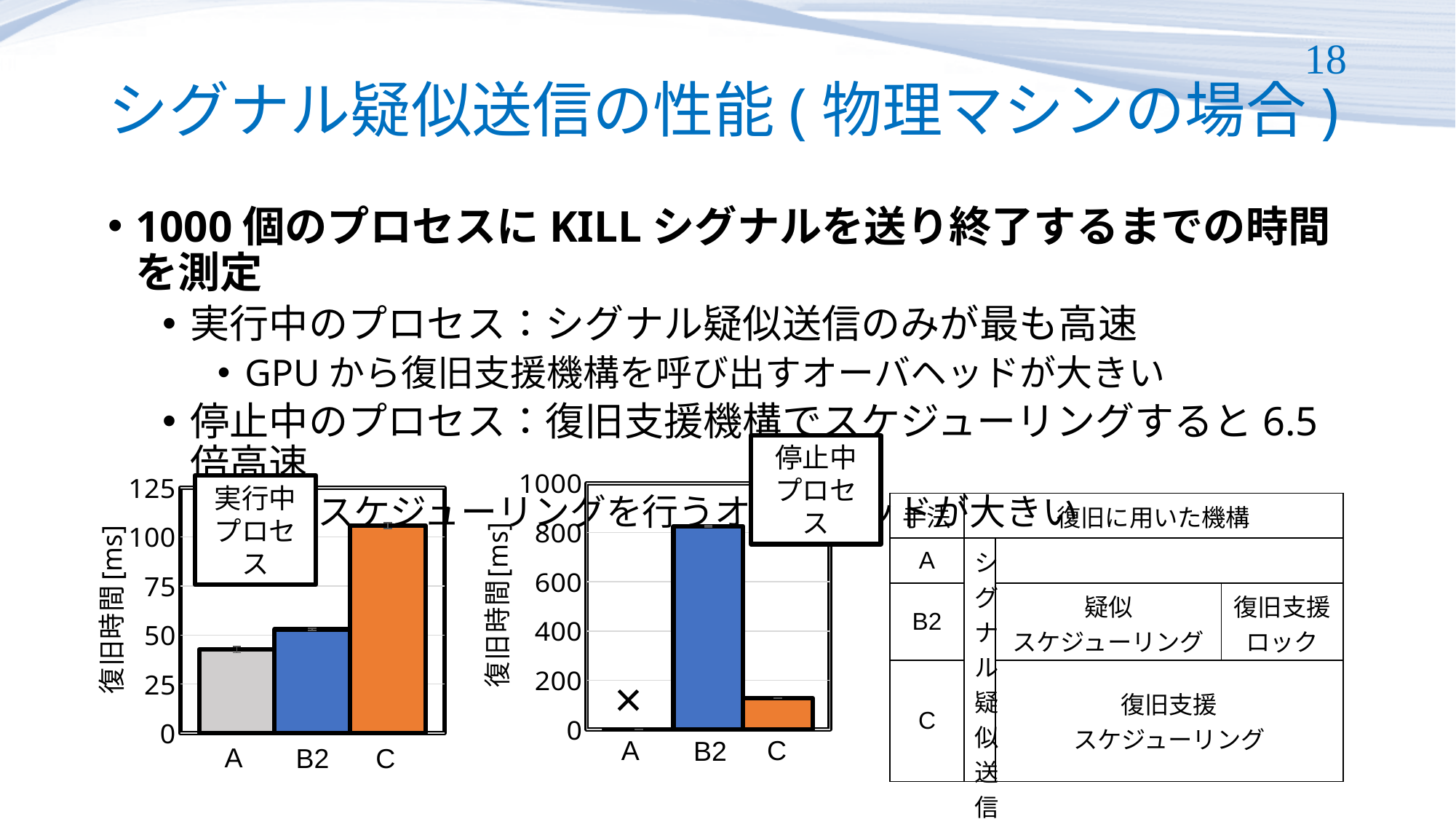
How many categories are shown on the x axis of the left chart (実行中プロセス)? 3 In the middle chart (停止中プロセス), is the value for B2 greater or less than 600? greater In the middle chart (停止中プロセス), which category has the highest 復旧時間? B2 What kind of chart is the left chart labelled 実行中プロセス? bar chart In the left chart (実行中プロセス), which category has the lowest 復旧時間? A In the middle chart (停止中プロセス), which is larger, the value for B2 or the value for C? B2 In the left chart (実行中プロセス), which category has the highest 復旧時間? C In the left chart (実行中プロセス), is the value for C greater or less than 100? greater What is the y-axis label of the left chart (実行中プロセス)? 復旧時間 [ms] In the left chart (実行中プロセス), is the value for A greater or less than 50? less In the left chart (実行中プロセス), do the values rise or fall from A to C along the x axis? rise